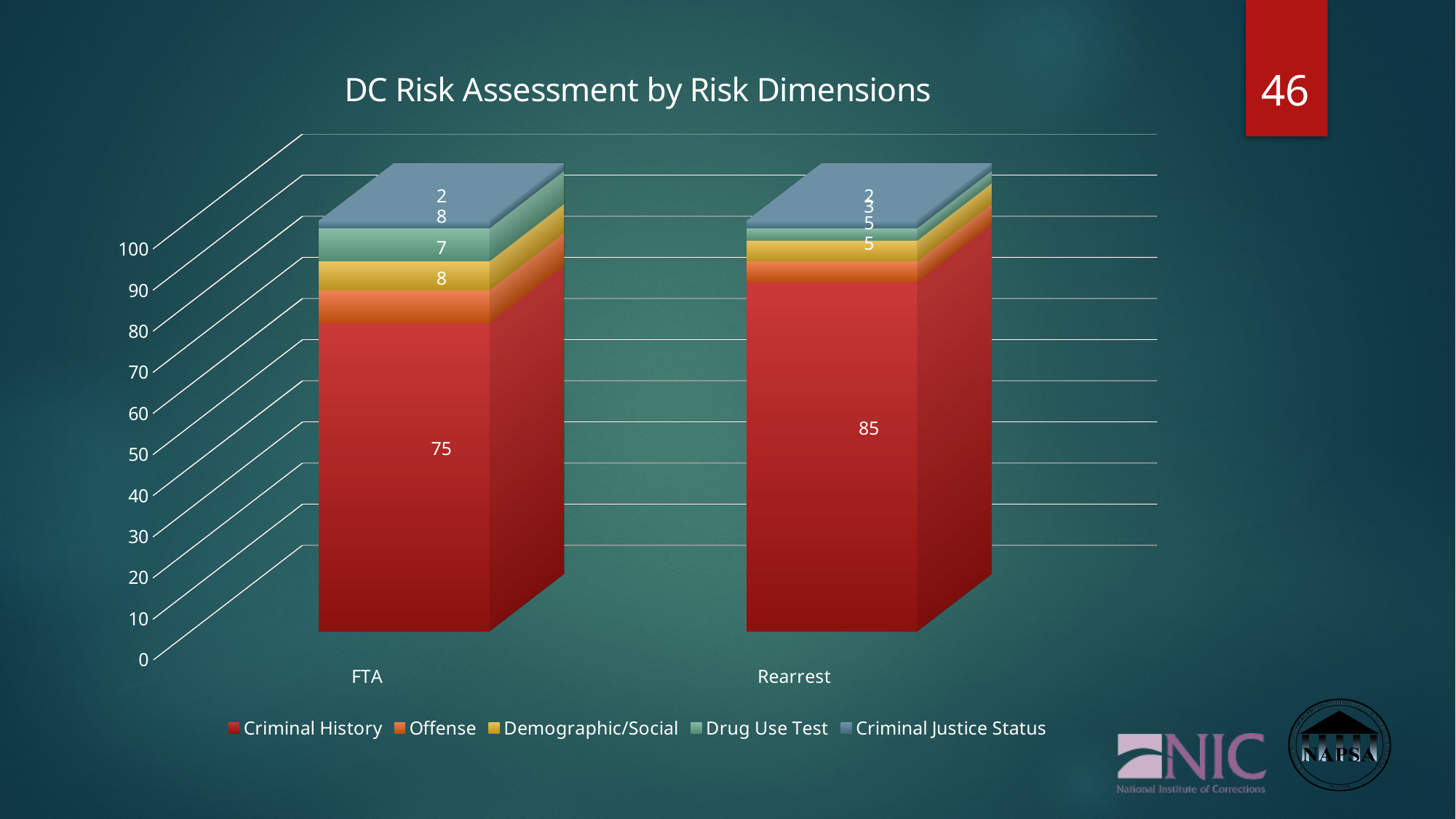
How many categories are shown on the x axis? 2 What is the Criminal History value for FTA? 75 What is the Drug Use Test value for Rearrest? 3 What is the Demographic/Social value for FTA? 7 What is the Criminal Justice Status value for Rearrest? 2 What is the title of the chart? DC Risk Assessment by Risk Dimensions What is the difference between the Criminal History values for Rearrest and FTA? 10 What is the Criminal History value for Rearrest? 85 How many series does the legend list? 5 What type of chart is shown on the slide? Stacked bar chart What is the total of the stacked bar for FTA? 100 Which category has the larger Criminal History value, FTA or Rearrest? Rearrest